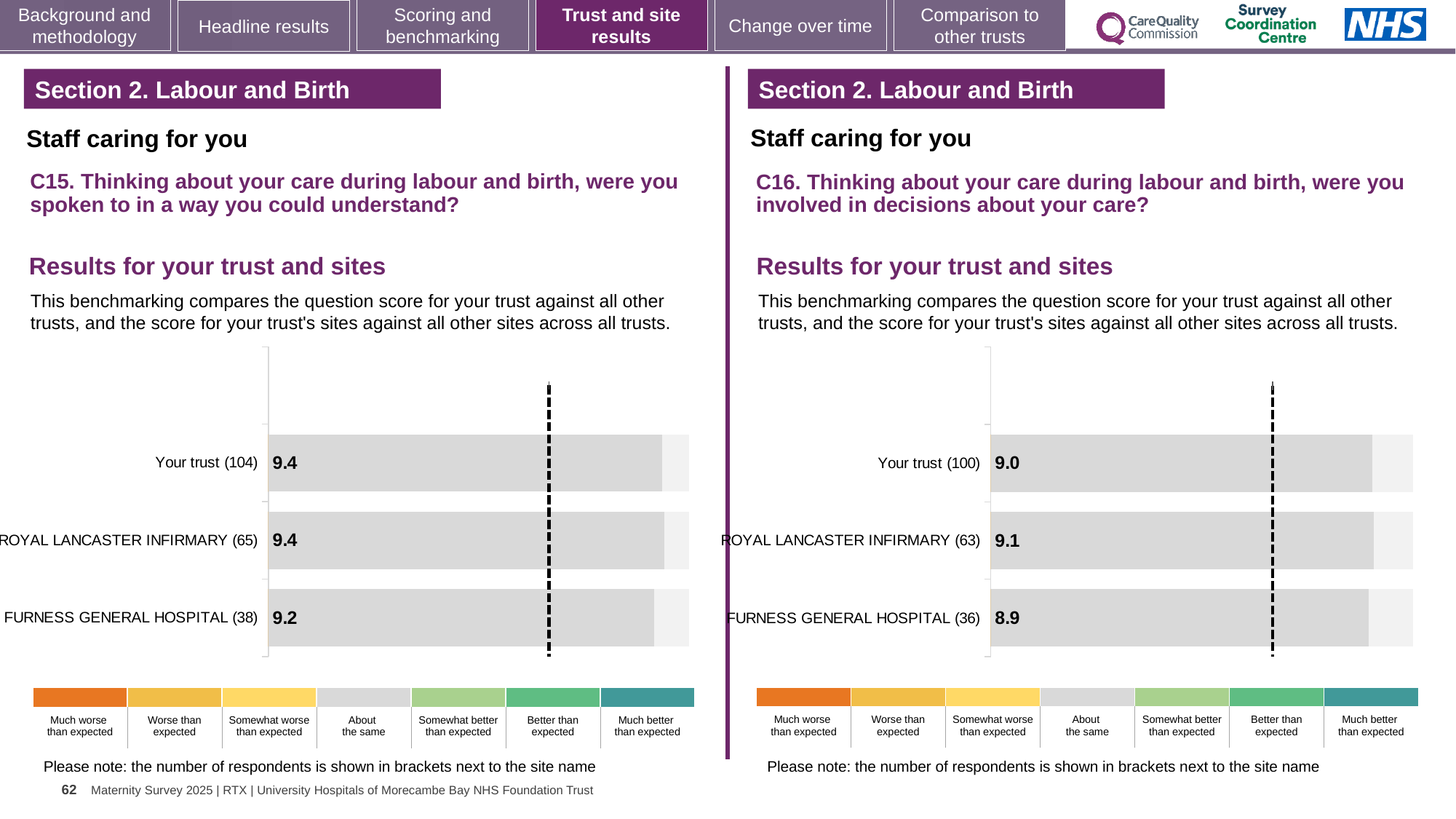
In the C16 chart on the right, how many respondents are shown in brackets for Your trust? 100 In the C16 chart on the right, what is the score for Furness General Hospital? 8.9 In the C15 chart on the left, which has the larger score: Your trust or Furness General Hospital? Your trust In the C16 chart on the right, which site or trust has the highest score? Royal Lancaster Infirmary What type of chart is used for the C15 results on the left? Bar chart In the C15 chart on the left, what is the score for Your trust? 9.4 In the C16 chart on the right, what is the difference between the scores for Royal Lancaster Infirmary and Furness General Hospital? 0.2 In the C16 chart on the right, what is the score for Royal Lancaster Infirmary? 9.1 In the C16 chart on the right, which site or trust has the lowest score? Furness General Hospital In the C15 chart on the left, which site or trust has the lowest score? Furness General Hospital How many bars are shown in the C16 chart on the right? 3 In the C15 chart on the left, what is the score for Furness General Hospital? 9.2